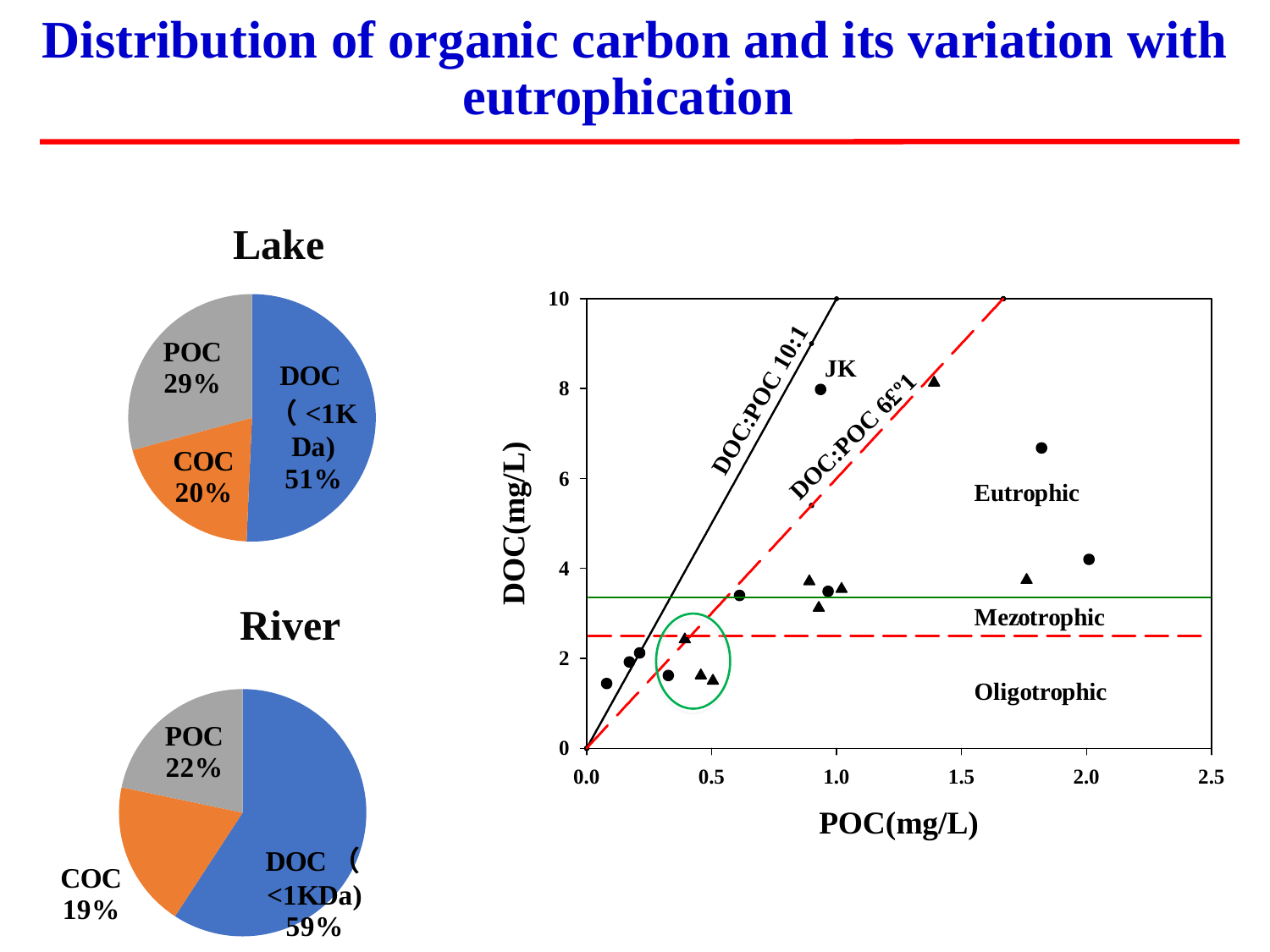
In the Lake pie chart, what share does COC have? 20% In the Lake pie chart, which slice is the smallest? COC In the River pie chart, which slice is the largest? DOC (<1KDa) Is the POC share larger in the Lake pie chart or the River pie chart? Lake In the Lake pie chart, what share does DOC (<1K Da) have? 51% How many slices does the River pie chart have? 3 How much larger is the DOC (<1KDa) share in the River pie chart than the DOC (<1K Da) share in the Lake pie chart? 8% In the scatter plot on the right, is the DOC value of the point labelled JK greater or less than 6? greater In the scatter plot on the right, what is the label of the x axis? POC(mg/L) What kind of chart is the chart on the right of the slide with POC(mg/L) on the x axis? Scatter plot In the River pie chart, what share does POC have? 22% What kind of chart is the Lake chart? Pie chart